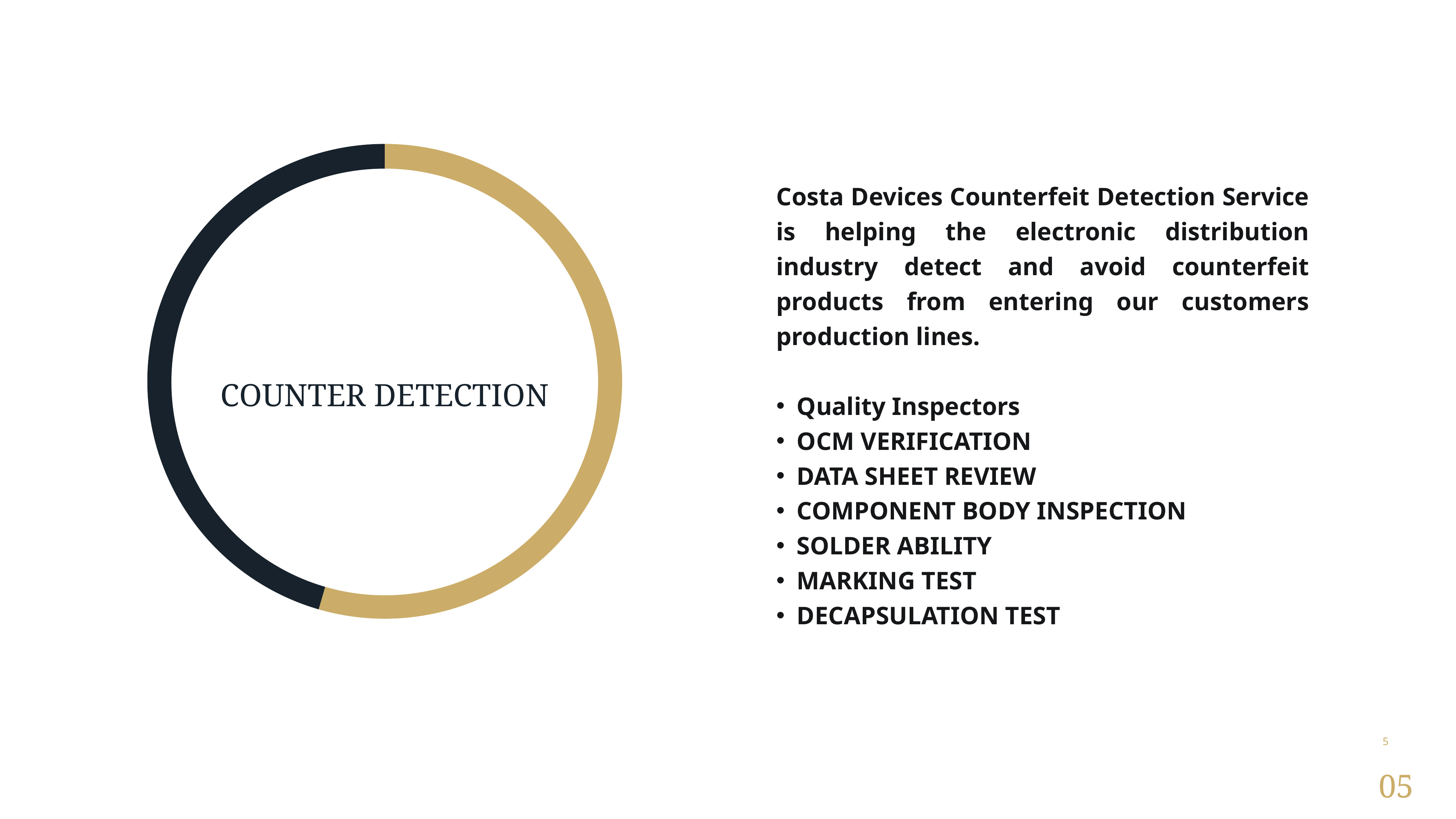
Which colour segment takes up the largest share of the doughnut chart? gold Which segment of the doughnut chart is larger, the gold one or the dark navy one? the gold one Does the doughnut chart display any data labels with values? No What text is displayed in the centre of the doughnut chart? COUNTER DETECTION How many segments does the doughnut chart have? 2 Which colour segment takes up the smallest share of the doughnut chart? dark navy What kind of chart is shown on the left of the slide? doughnut chart